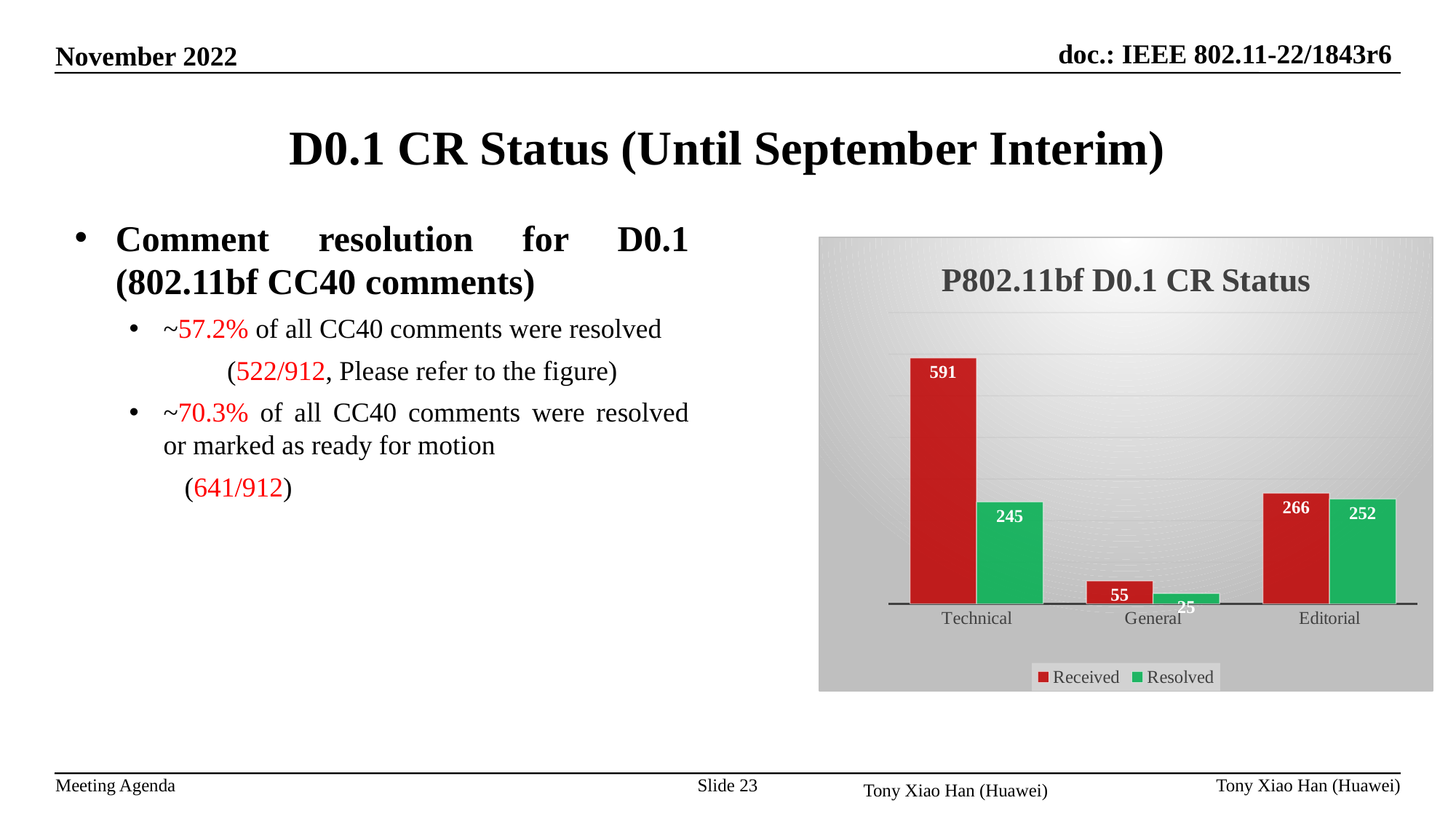
Which is larger, the Resolved value for Technical or the Resolved value for Editorial? Editorial What is the difference between Received and Resolved for Editorial? 14 What is the title of the chart? P802.11bf D0.1 CR Status What kind of chart is shown? bar chart What is the Resolved value for Editorial? 252 Which category has the highest Received value? Technical How many categories are shown on the x axis? 3 What is the difference between Received and Resolved for Technical? 346 What is the Resolved value for General? 25 Which category has the lowest Resolved value? General How many series does the legend list? 2 What is the Received value for Technical? 591